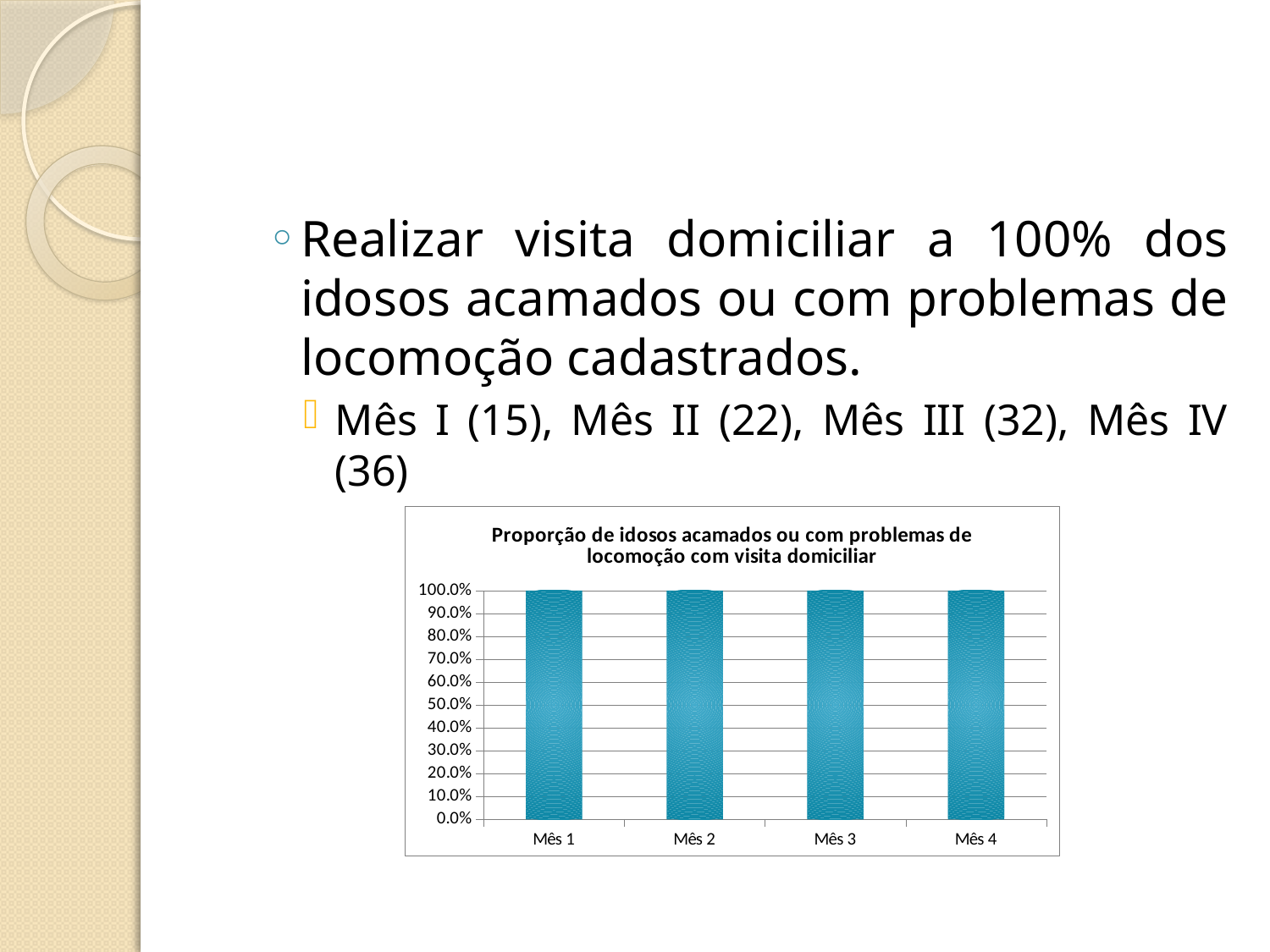
What kind of chart is shown on the slide? bar chart What is the title of the chart? Proporção de idosos acamados ou com problemas de locomoção com visita domiciliar What is the value for Mês 3 in the chart? 100.0% What is the difference between the values for Mês 1 and Mês 4? 0.0% Do the values rise, fall, or stay the same from Mês 1 to Mês 4? stay the same What is the highest value shown on the y axis of the chart? 100.0% What is the value for Mês 1 in the chart? 100.0% How many categories are plotted on the x axis of the chart? 4 Is the value for Mês 2 greater or less than 50.0%? greater What is the value for Mês 4 in the chart? 100.0% What is the label of the first category on the x axis? Mês 1